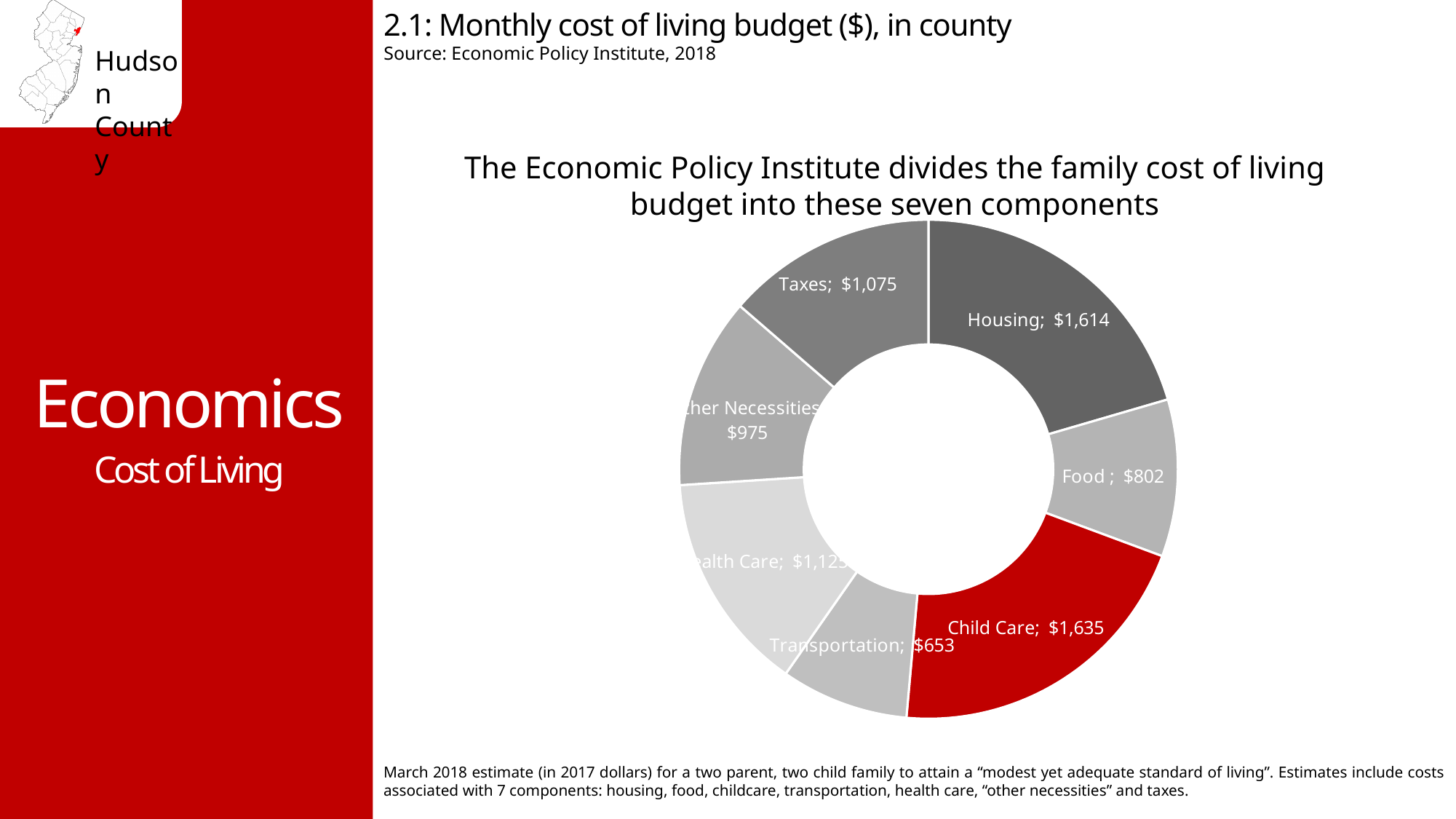
What is the monthly cost for Taxes? $1,075 What is the monthly cost for Transportation? $653 How many components are shown in the chart? 7 Which is larger, the monthly cost for Taxes or for Other Necessities? Taxes What is the monthly cost for Housing? $1,614 What is the monthly cost for Child Care? $1,635 What is the monthly cost for Food? $802 What kind of chart is shown on the slide? doughnut chart Which component has the highest monthly cost? Child Care How much more is the monthly cost for Housing than for Food? $812 What is the monthly cost for Other Necessities? $975 Which component has the lowest monthly cost? Transportation